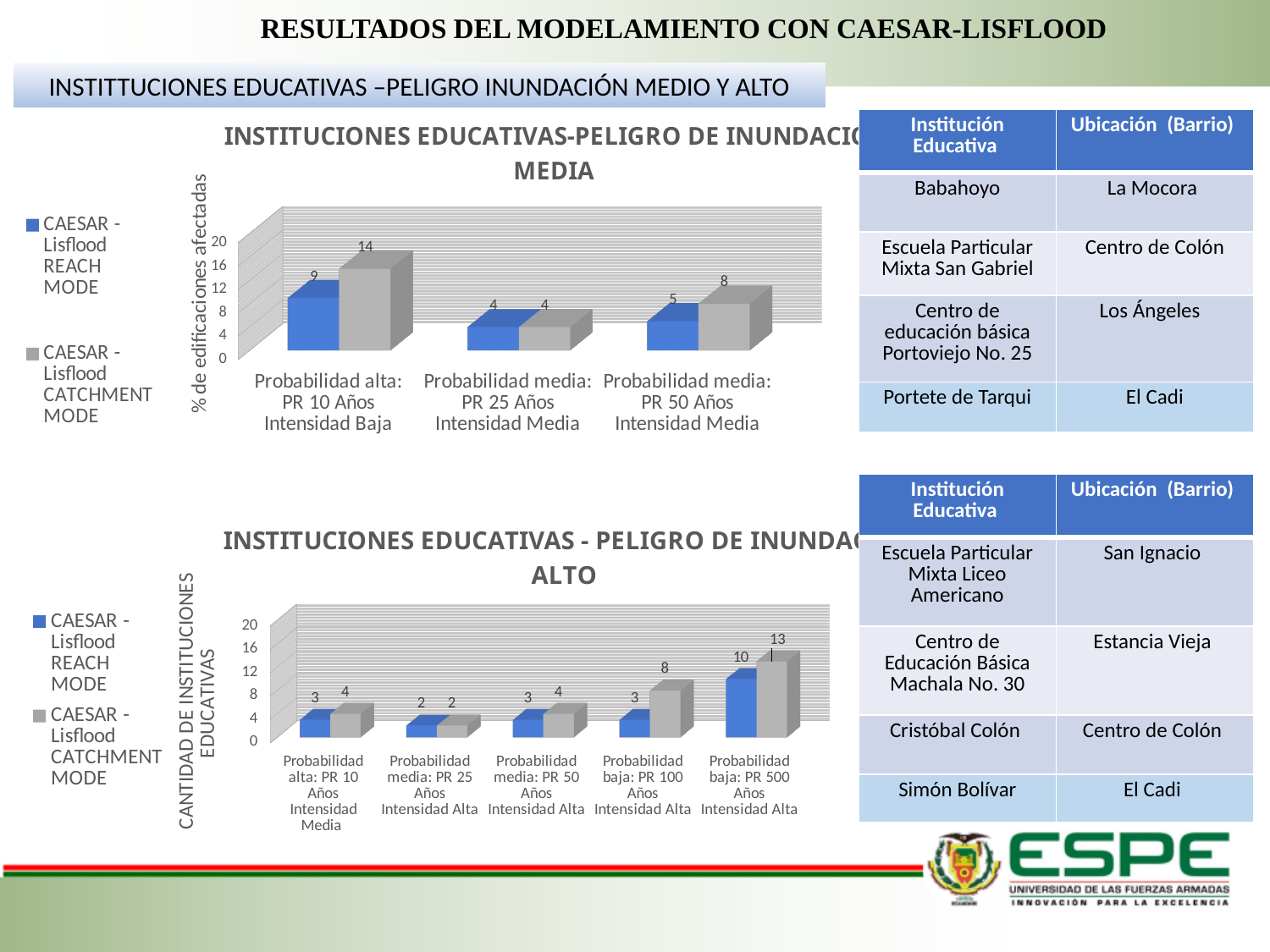
In the bottom chart (peligro de inundación alto), what is the difference between the CATCHMENT MODE and REACH MODE values for 'Probabilidad baja: PR 100 Años Intensidad Alta'? 5 In the top chart (peligro de inundación media), what is the value for CAESAR-Lisflood REACH MODE in the category 'Probabilidad media: PR 50 Años Intensidad Media'? 5 In the bottom chart (peligro de inundación alto), what is the value for CAESAR-Lisflood REACH MODE in the category 'Probabilidad baja: PR 100 Años Intensidad Alta'? 3 In the top chart (peligro de inundación media), what is the difference between the CATCHMENT MODE and REACH MODE values for 'Probabilidad alta: PR 10 Años Intensidad Baja'? 5 In the bottom chart (peligro de inundación alto), what is the value for CAESAR-Lisflood CATCHMENT MODE in the category 'Probabilidad baja: PR 500 Años Intensidad Alta'? 13 How many series does the legend of the bottom chart (peligro de inundación alto) list? 2 In the top chart (peligro de inundación media), what is the value for CAESAR-Lisflood CATCHMENT MODE in the category 'Probabilidad alta: PR 10 Años Intensidad Baja'? 14 In the top chart (peligro de inundación media), how many categories are shown on the x axis? 3 In the bottom chart (peligro de inundación alto), how many categories are shown on the x axis? 5 In the top chart (peligro de inundación media), which category has the highest value for CAESAR-Lisflood CATCHMENT MODE? Probabilidad alta: PR 10 Años Intensidad Baja In the bottom chart (peligro de inundación alto), which is larger: the REACH MODE value for 'Probabilidad baja: PR 500 Años Intensidad Alta' or the CATCHMENT MODE value for 'Probabilidad baja: PR 100 Años Intensidad Alta'? REACH MODE value for PR 500 Años (10) In the bottom chart (peligro de inundación alto), which category has the lowest value for CAESAR-Lisflood REACH MODE? Probabilidad media: PR 25 Años Intensidad Alta